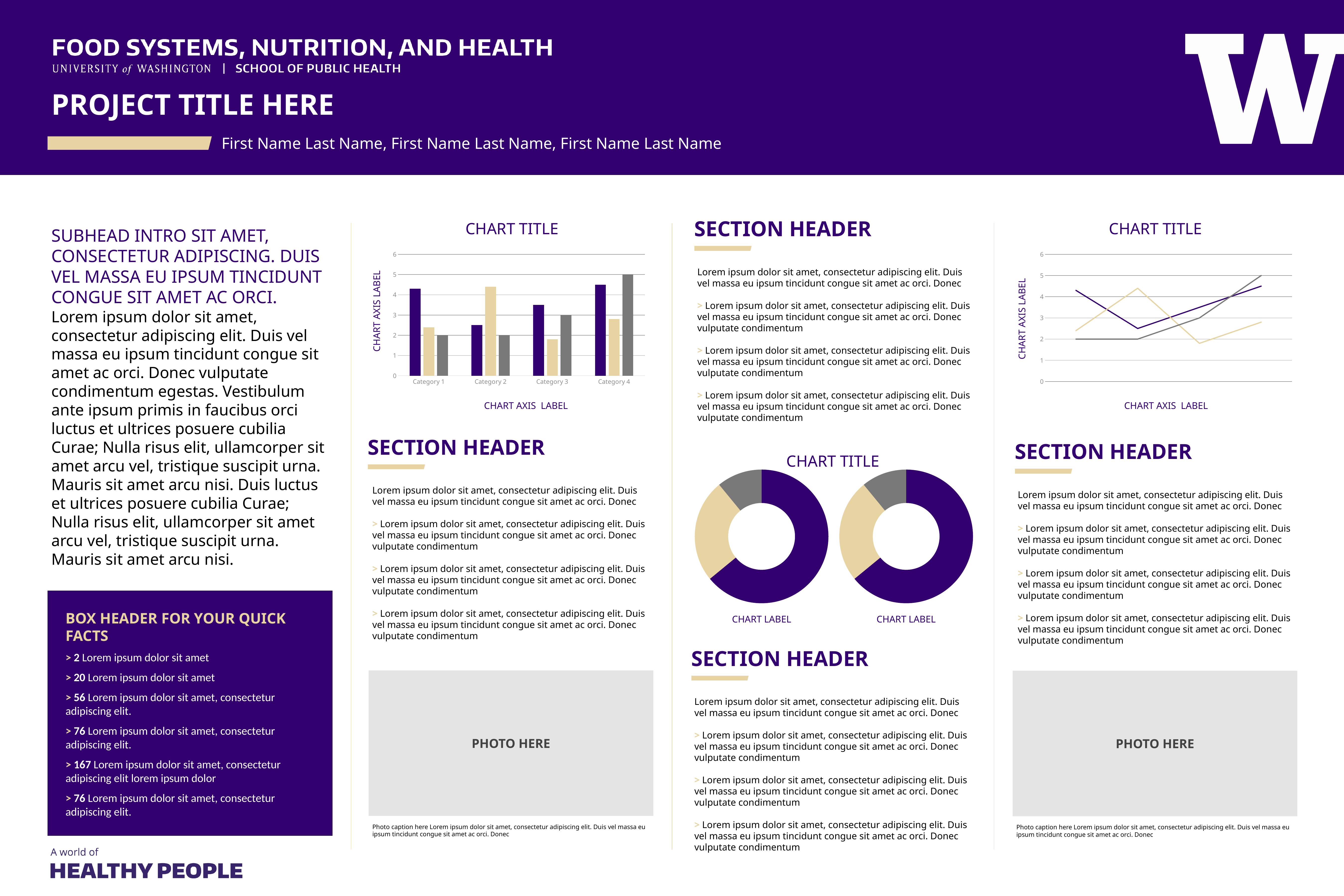
In the bar chart in the left column, what is the value of the gray bar for Category 3? 3 In the bar chart in the left column, for Category 3, which is larger: the purple bar or the gray bar? the purple bar In the bar chart in the left column, is the purple bar for Category 1 greater or less than 4? greater In the bar chart in the left column, which category has the highest tan bar? Category 2 What kind of chart is the chart in the right column titled CHART TITLE? line chart In the bar chart in the left column, is the purple bar for Category 2 greater or less than 3? less In the bar chart in the left column, what is the value of the gray bar for Category 1? 2 In the two donut charts in the middle column, which colour slice is the largest in each chart? purple In the bar chart in the left column, what is the value of the gray bar for Category 4? 5 What kind of chart is the chart in the left column titled CHART TITLE? bar chart In the bar chart in the left column, how many categories are shown on the x axis? 4 In the line chart in the right column, does the gray line rise or fall from left to right? rises